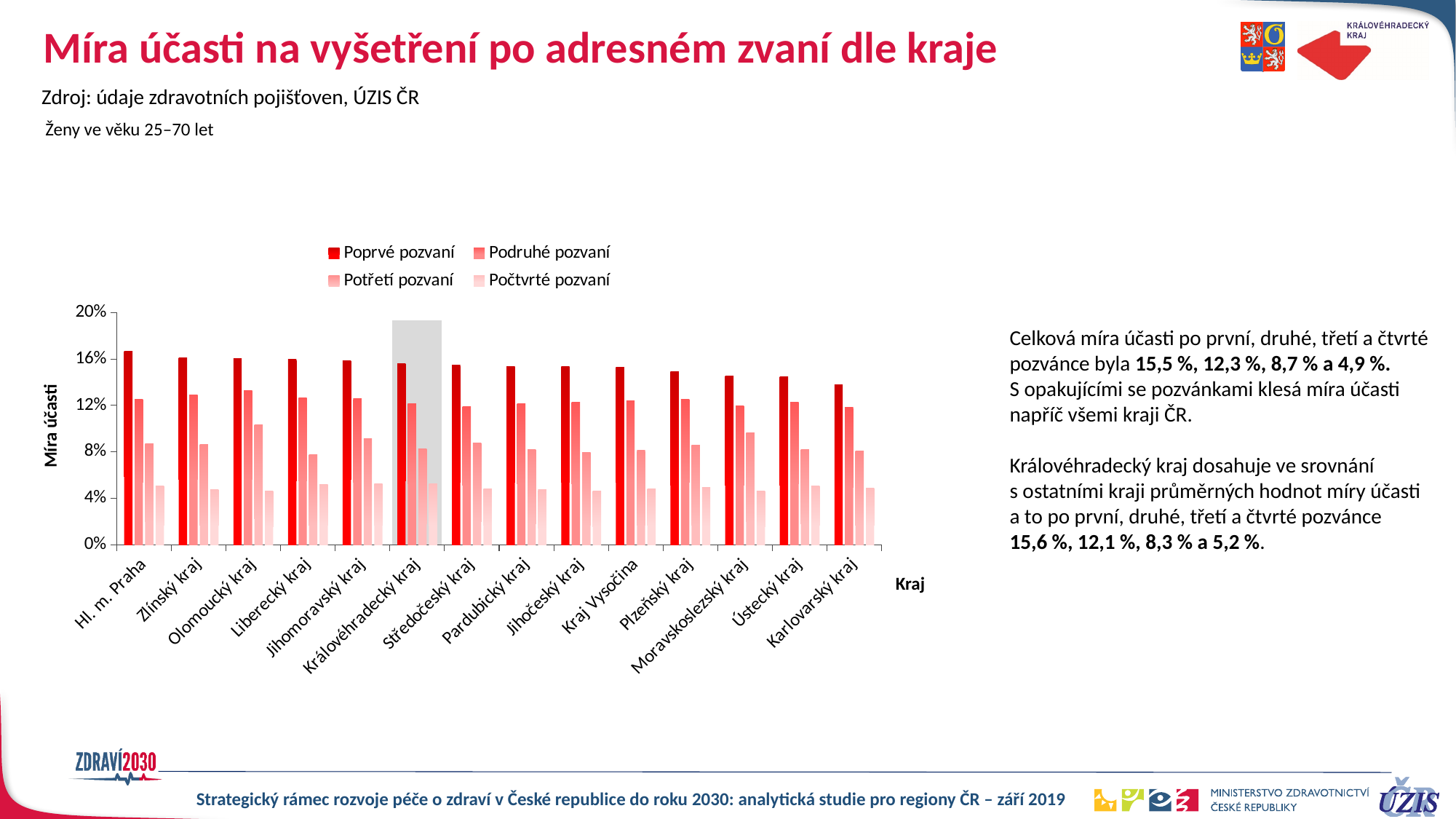
How many series does the legend list? 4 Which region has the highest value for Poprvé pozvaní? Hl. m. Praha Is the Počtvrté pozvaní value for Olomoucký kraj greater or less than 8%? less Is the Podruhé pozvaní value for Zlínský kraj greater or less than 12%? greater Which is larger for Olomoucký kraj: the Potřetí pozvaní value or the Počtvrté pozvaní value? Potřetí pozvaní According to the slide, what is the participation rate for Královéhradecký kraj after the first invitation (Poprvé pozvaní)? 15,6 % What kind of chart is shown on the slide? bar chart Which region is highlighted with a grey background in the chart? Královéhradecký kraj Is the Poprvé pozvaní value for Hl. m. Praha greater or less than 16%? greater Which region has the lowest value for Poprvé pozvaní? Karlovarský kraj How many regions (kraje) are shown on the x axis? 14 Do the Poprvé pozvaní values generally rise or fall moving from left to right along the x axis? fall